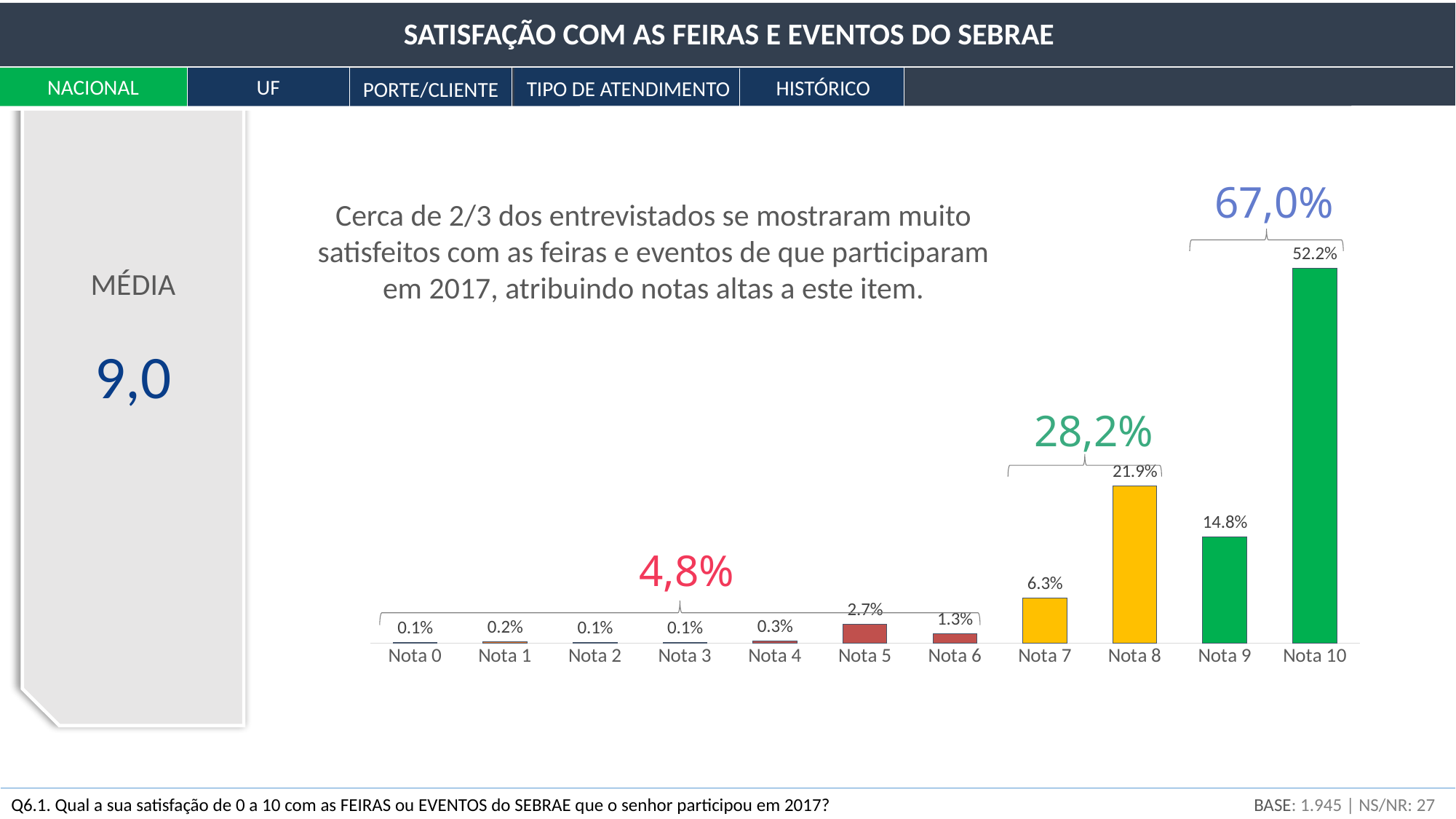
Which is larger, the value for Nota 7 or the value for Nota 9? Nota 9 What is the average (MÉDIA) shown on the left of the slide? 9,0 What is the value for Nota 10? 52.2% How many categories are shown on the x axis of the chart? 11 What is the value for Nota 8? 21.9% What is the combined share shown for Nota 0 through Nota 6 (the bracket label above them)? 4,8% What is the combined share shown for Nota 9 and Nota 10 (the bracket label above them)? 67,0% What kind of chart is shown on the slide? bar chart Which category has the highest value? Nota 10 What is the difference between the values for Nota 10 and Nota 9? 37.4% What colour are the bars for Nota 7 and Nota 8? yellow What is the value for Nota 5? 2.7%